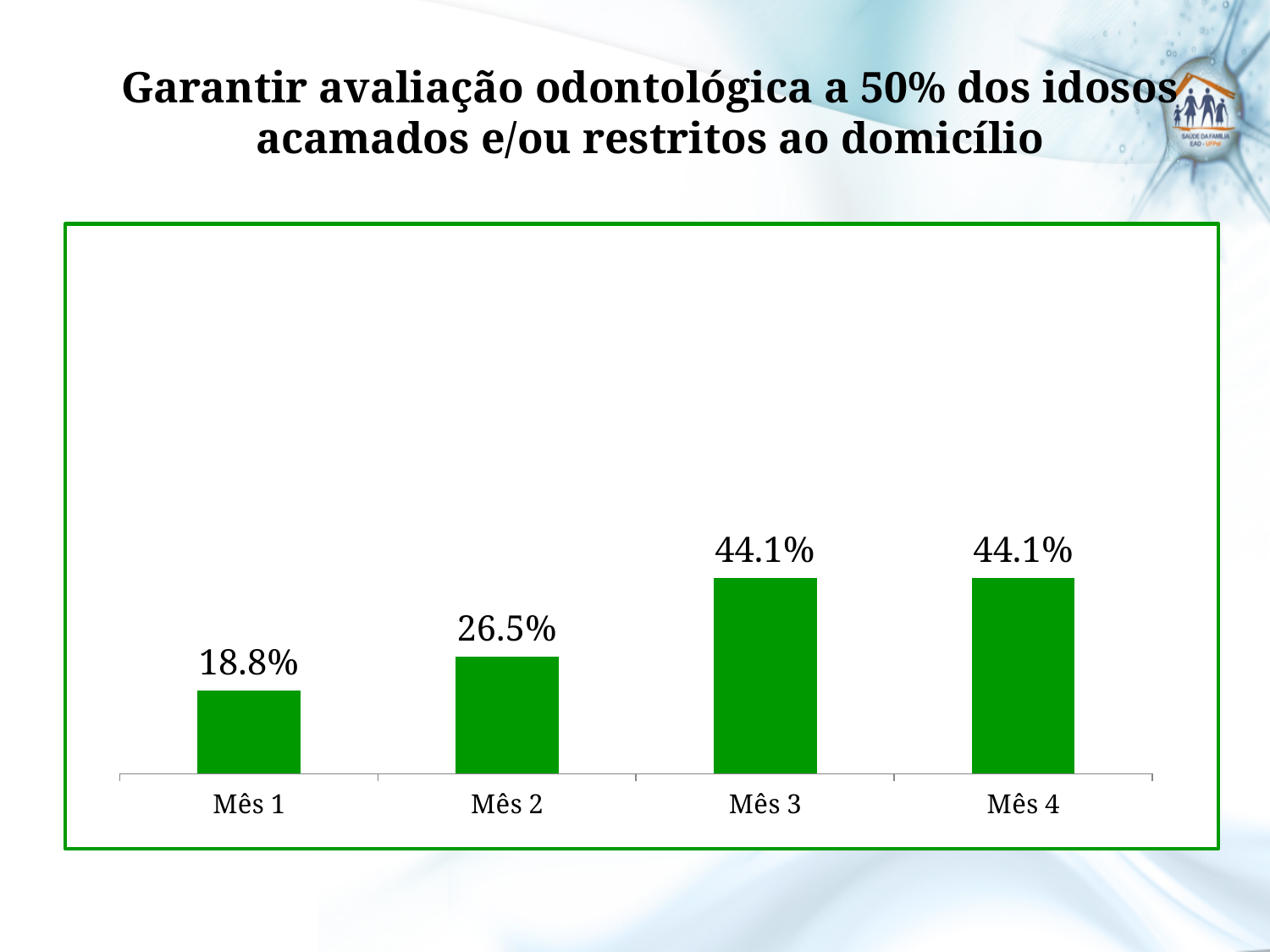
What is the value for Mês 4? 44.1% How many months are shown on the x axis? 4 Which month has the lowest value? Mês 1 What is the difference between the values for Mês 2 and Mês 1? 7.7% What colour are the bars in the chart? Green What is the value for Mês 2? 26.5% What kind of chart is shown on the slide? Bar chart What is the difference between the values for Mês 3 and Mês 1? 25.3% What is the value for Mês 3? 44.1% Do the values rise or fall from Mês 1 to Mês 3? Rise Which is larger, the value for Mês 2 or the value for Mês 3? Mês 3 What is the value for Mês 1? 18.8%